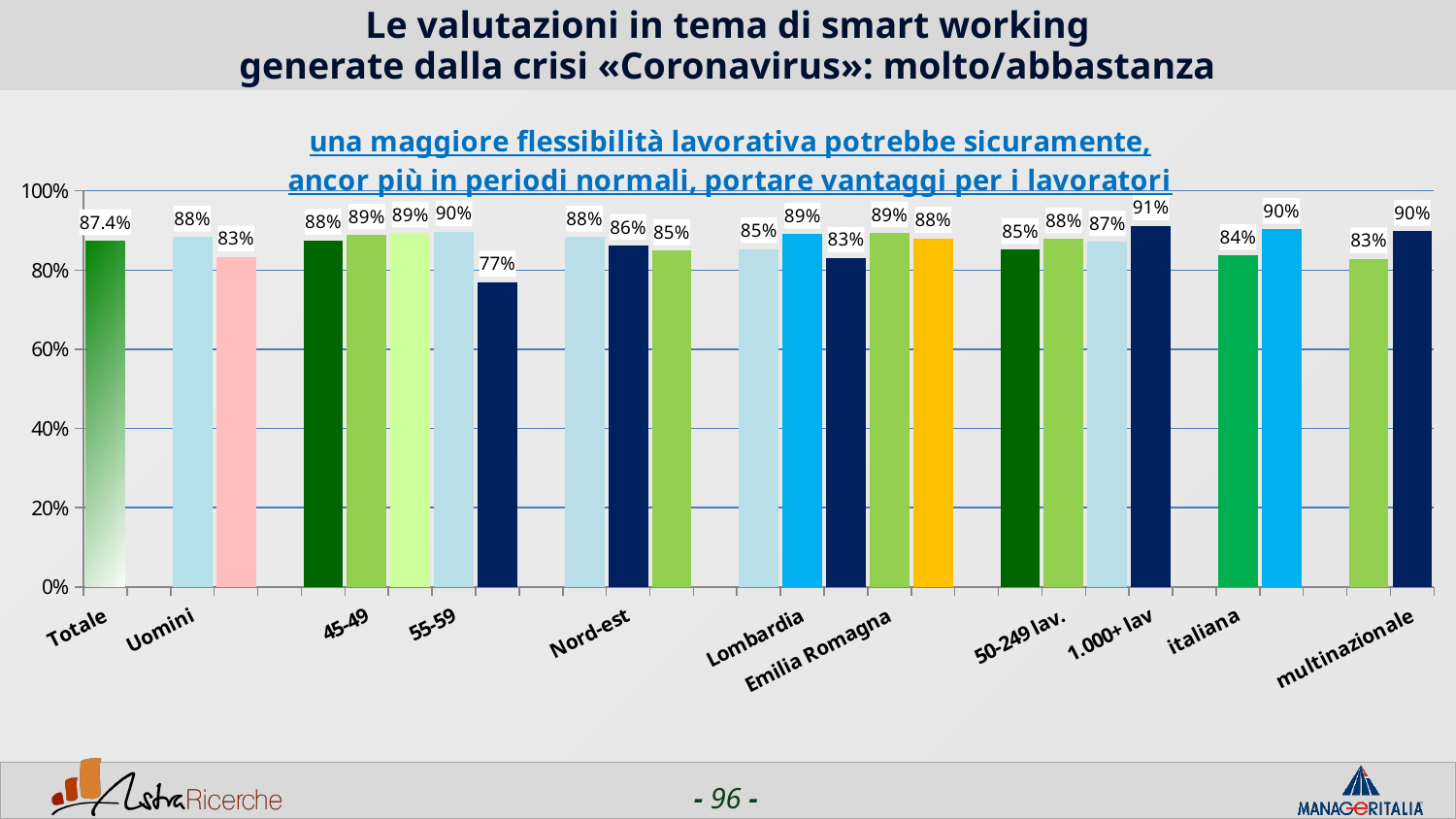
What is the value for Lombardia? 89% What is the lowest value shown on the chart? 77% What kind of chart is shown on the slide? Bar chart Which labelled category has the highest value? 1.000+ lav What is the value for 1.000+ lav? 91% What is the value for the 55-59 age group? 90% Which is larger, the value for 55-59 or the value for Nord-est? 55-59 What is the value for multinazionale? 90% What is the value for Uomini? 88% What is the difference between the values for 1.000+ lav and Nord-est? 5 percentage points What is the value for Nord-est? 86% What is the value for Totale? 87.4%